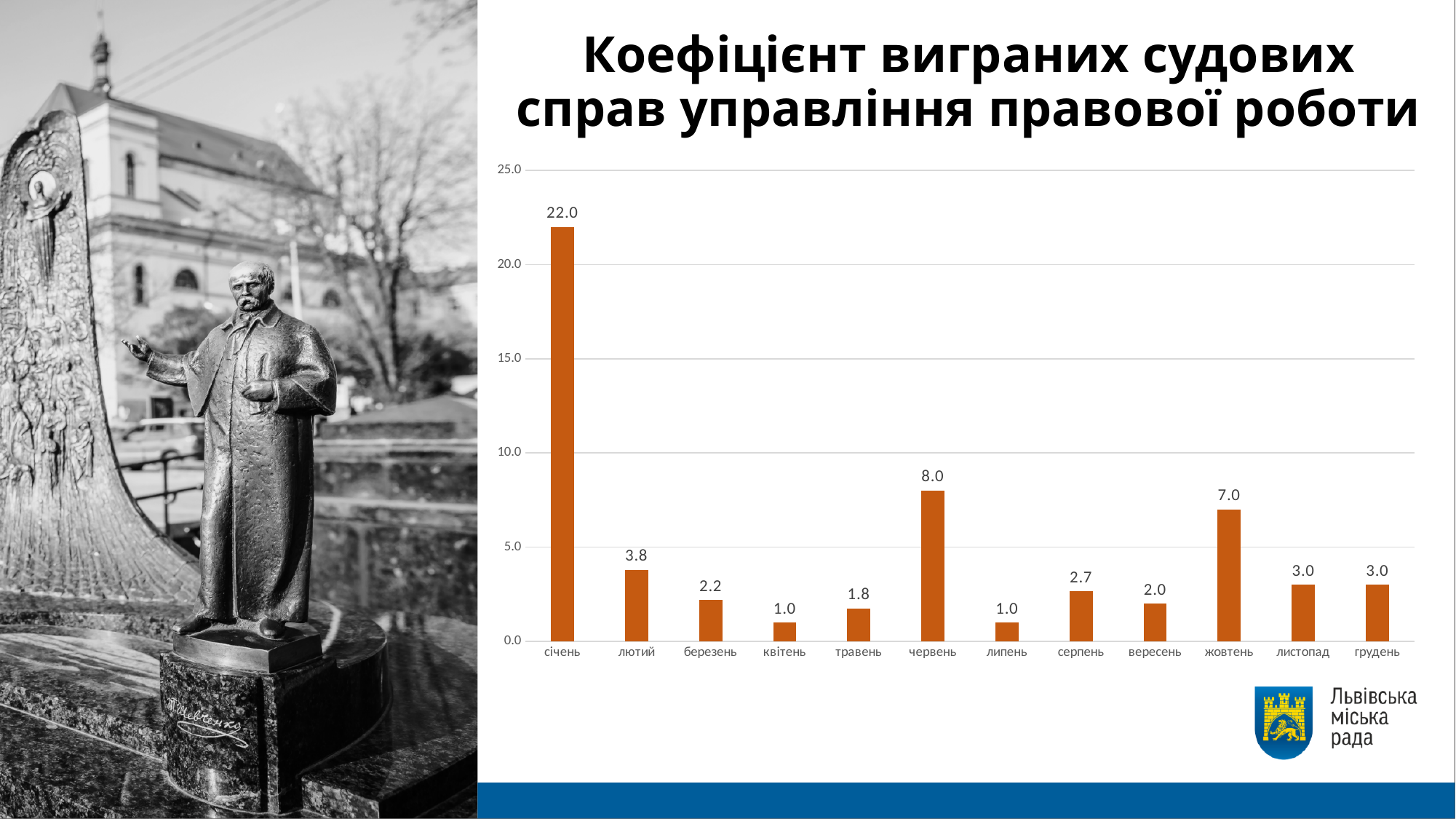
Which month has the highest value? січень How many months are shown on the x axis? 12 What is the title of the chart? Коефіцієнт виграних судових справ управління правової роботи What kind of chart is shown on the slide? bar chart What is the value for червень? 8.0 What is the value for жовтень? 7.0 Is the value for січень greater or less than 20.0? greater Which is larger, the value for серпень or the value for вересень? серпень How many months have a value of 1.0? 2 What is the value for січень? 22.0 What is the value for лютий? 3.8 What is the difference between the values for січень and червень? 14.0